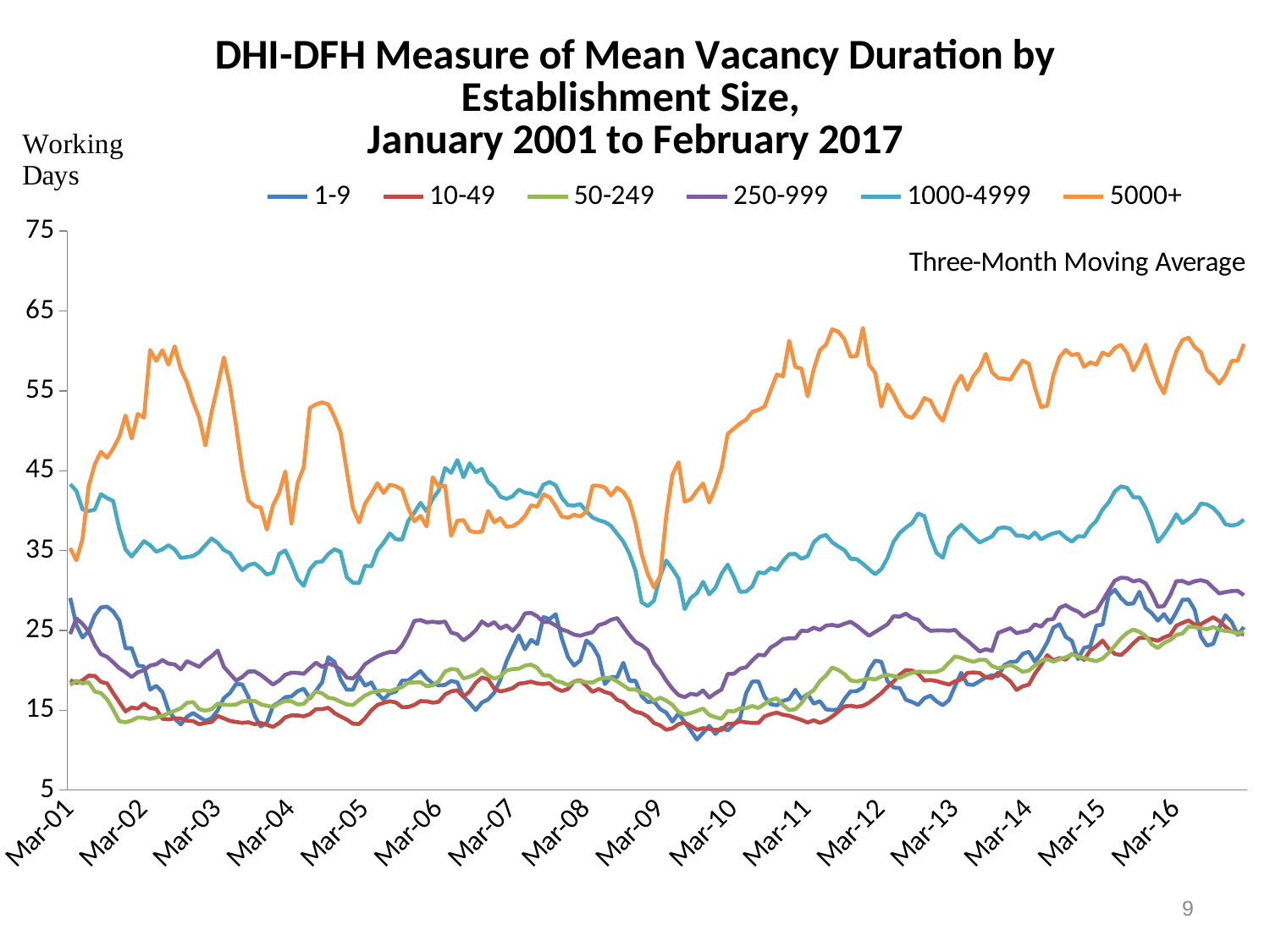
What unit is shown on the y axis label? Working Days Does the 5000+ series rise or fall between Mar-09 and Mar-11? rise At Mar-11, which series has the larger value: 5000+ or 1000-4999? 5000+ Is the value for the 1000-4999 series at Mar-09 greater or less than 35? less How many year labels are shown on the x axis? 16 Which establishment size series has the highest values across most of the period shown? 5000+ Is the value for the 250-999 series at Mar-16 greater or less than 25? greater Is the value for the 10-49 series at Mar-10 greater or less than 15? less Does the 1000-4999 series rise or fall between Mar-01 and Mar-02? fall How many series does the legend list? 6 What kind of chart is shown on the slide? line chart